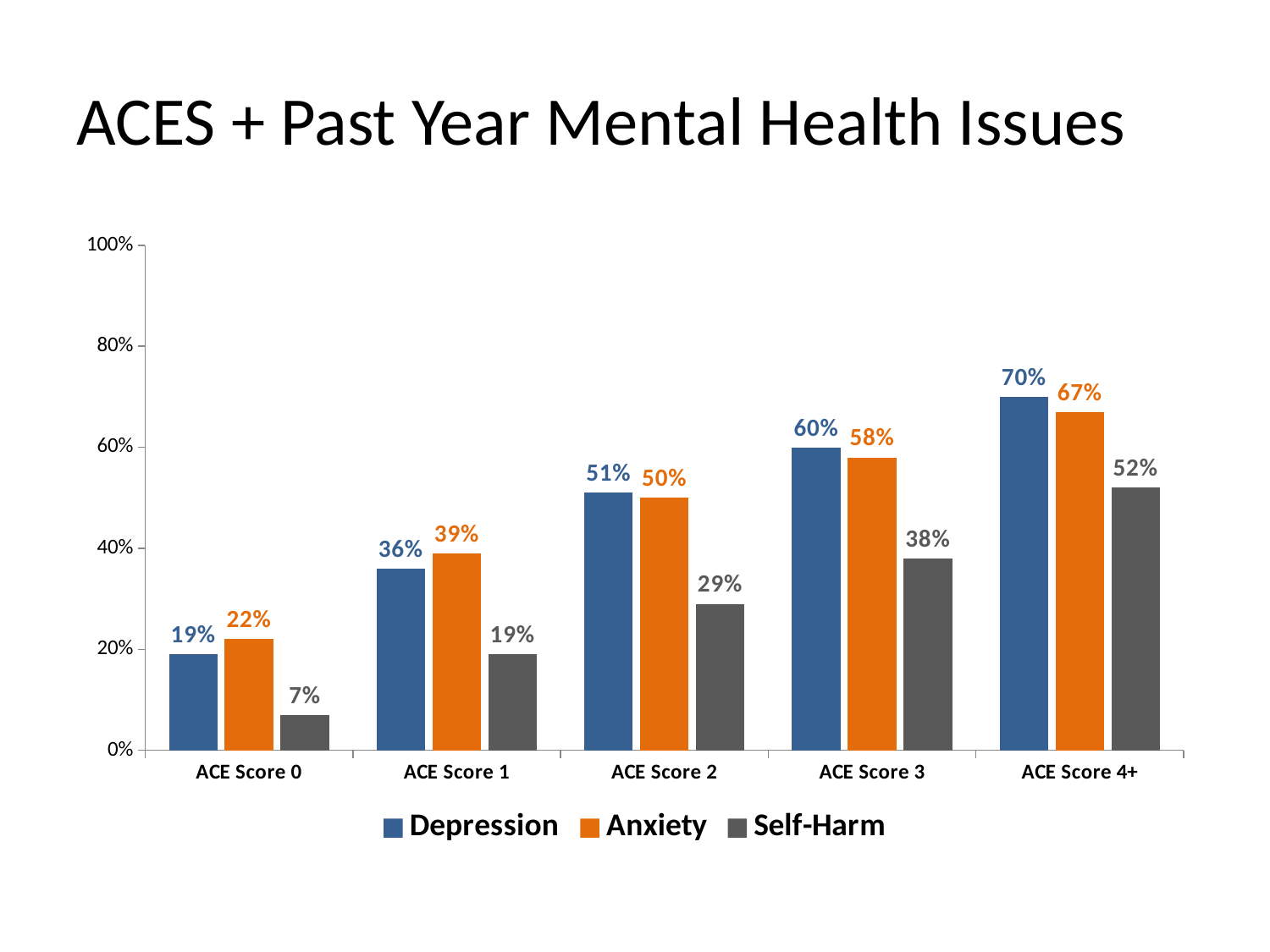
Which ACE Score category has the highest Self-Harm value? ACE Score 4+ What is the Self-Harm value for ACE Score 0? 7% Which ACE Score category has the lowest Depression value? ACE Score 0 How many series does the legend list? 3 Do the Depression values rise or fall as the ACE Score increases from 0 to 4+? Rise How many ACE Score categories are shown on the x axis? 5 Is the Anxiety value for ACE Score 3 greater or less than 40%? greater What kind of chart is shown on the slide? Bar chart What is the Anxiety value for ACE Score 4+? 67% For ACE Score 1, which is larger: Depression or Anxiety? Anxiety What is the Depression value for ACE Score 2? 51% What is the difference between the Depression and Self-Harm values for ACE Score 3? 22%